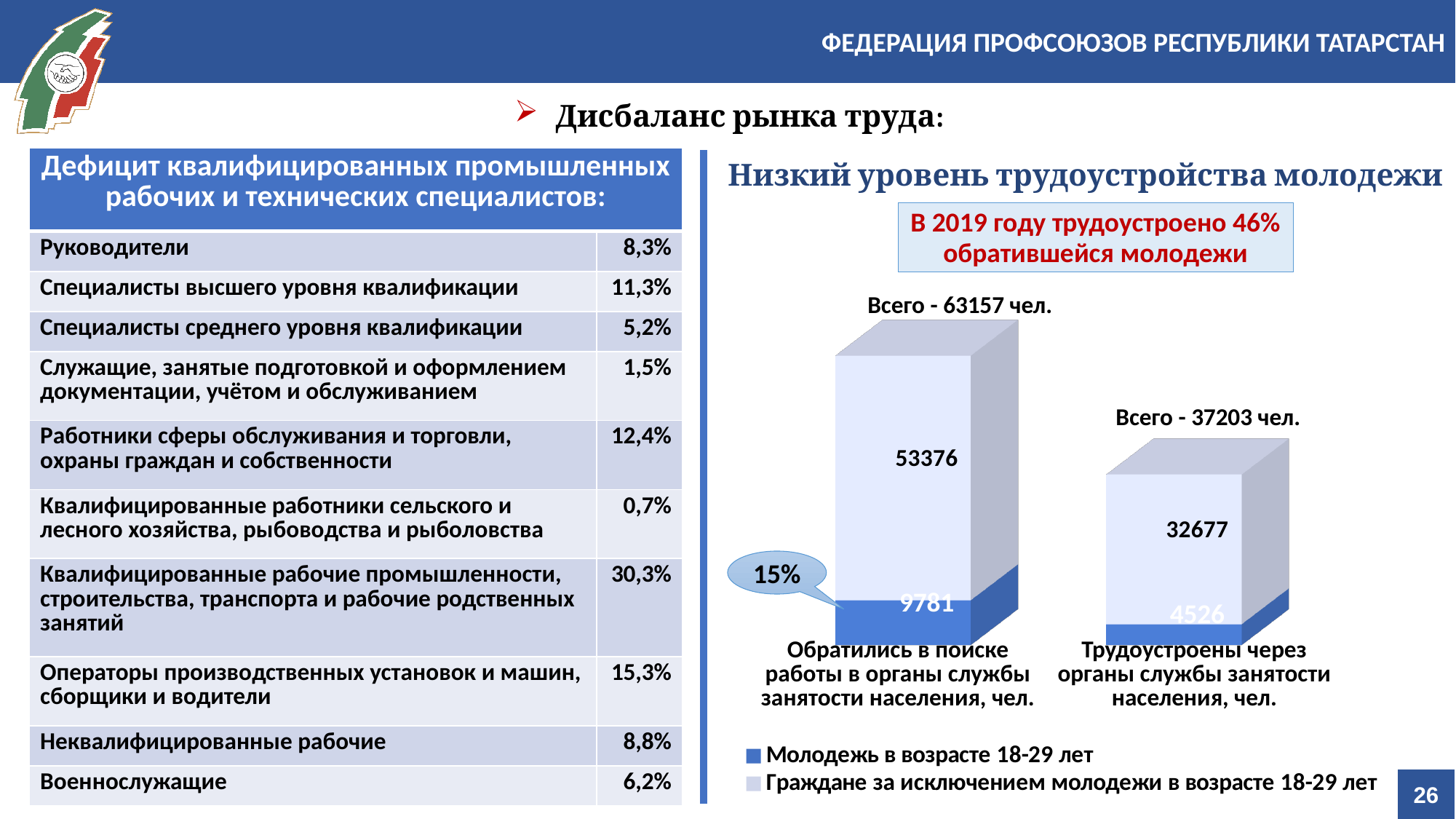
What is the value for 'Молодежь в возрасте 18-29 лет' in the bar 'Обратились в поиске работы в органы службы занятости населения, чел.'? 9781 What is the total of the stacked bar 'Обратились в поиске работы в органы службы занятости населения, чел.'? 63157 What kind of chart is shown on the right side of the slide? Stacked bar chart What is the total of the stacked bar 'Трудоустроены через органы службы занятости населения, чел.'? 37203 How many series does the chart legend list? 2 Which bar has the larger value for 'Молодежь в возрасте 18-29 лет': 'Обратились в поиске работы...' or 'Трудоустроены через органы службы занятости...'? Обратились в поиске работы в органы службы занятости населения, чел. What percentage is shown in the callout next to the youth segment of the 'Обратились в поиске работы...' bar? 15% What is the value for 'Граждане за исключением молодежи в возрасте 18-29 лет' in the bar 'Трудоустроены через органы службы занятости населения, чел.'? 32677 Which series is shown in dark blue in the chart? Молодежь в возрасте 18-29 лет How many categories (bars) are shown in the chart? 2 What is the value for 'Молодежь в возрасте 18-29 лет' in the bar 'Трудоустроены через органы службы занятости населения, чел.'? 4526 What is the difference between the 'Граждане за исключением молодежи в возрасте 18-29 лет' values of the two bars (53376 and 32677)? 20699